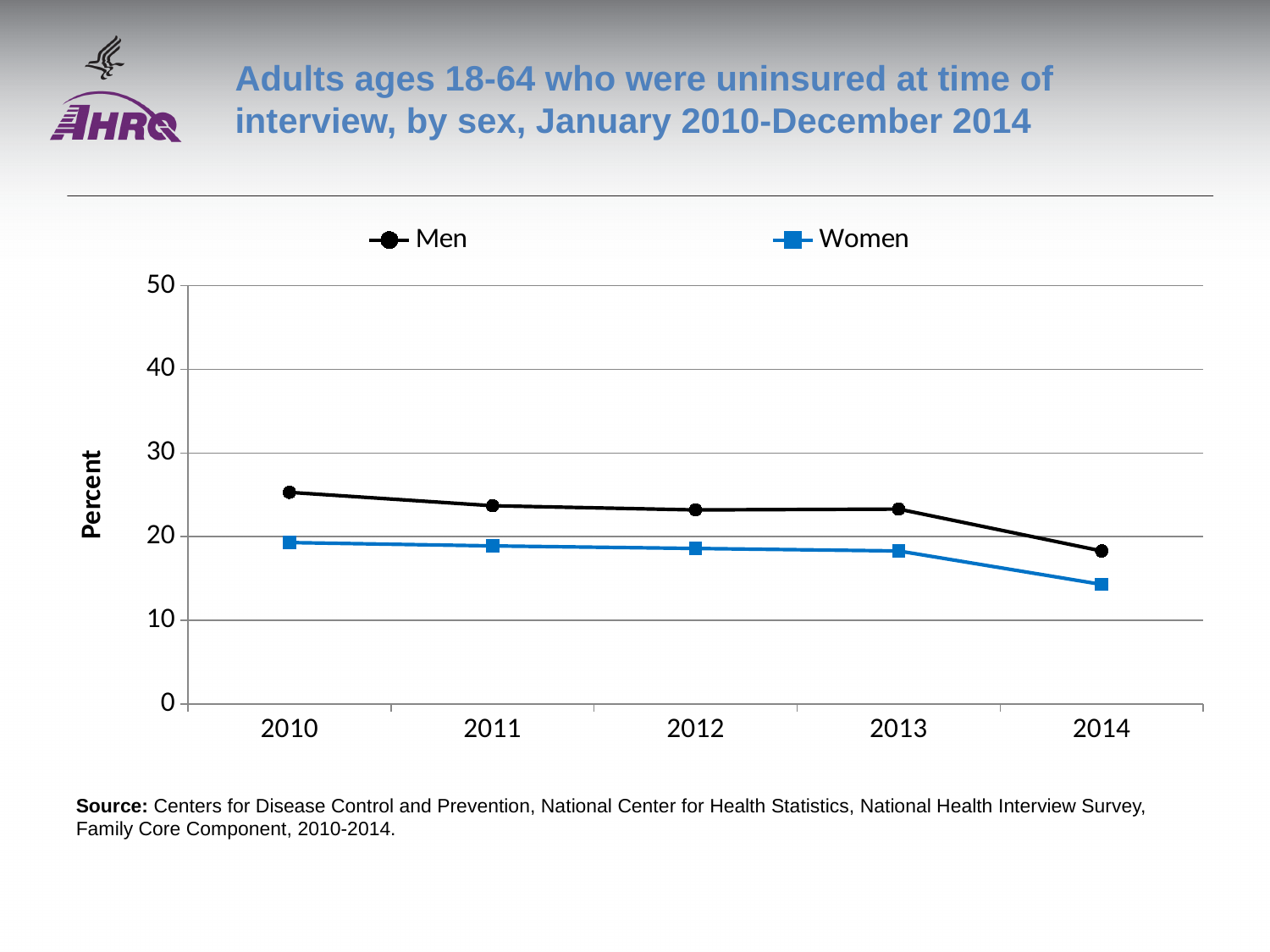
In which year is the value for Men lowest? 2014 Does the percentage of uninsured men rise or fall from 2010 to 2014? Fall Which series is plotted with the black line and circle markers? Men Is the value for Men in 2010 greater or less than 20? greater How many series does the legend list? 2 In which year is the value for Women lowest? 2014 How many years are plotted along the x axis? 5 In 2014, which series has the higher value, Men or Women? Men Does the percentage of uninsured women rise or fall from 2010 to 2014? Fall What is the label on the vertical axis? Percent What kind of chart is shown on the slide? Line chart In which year is the value for Men highest? 2010